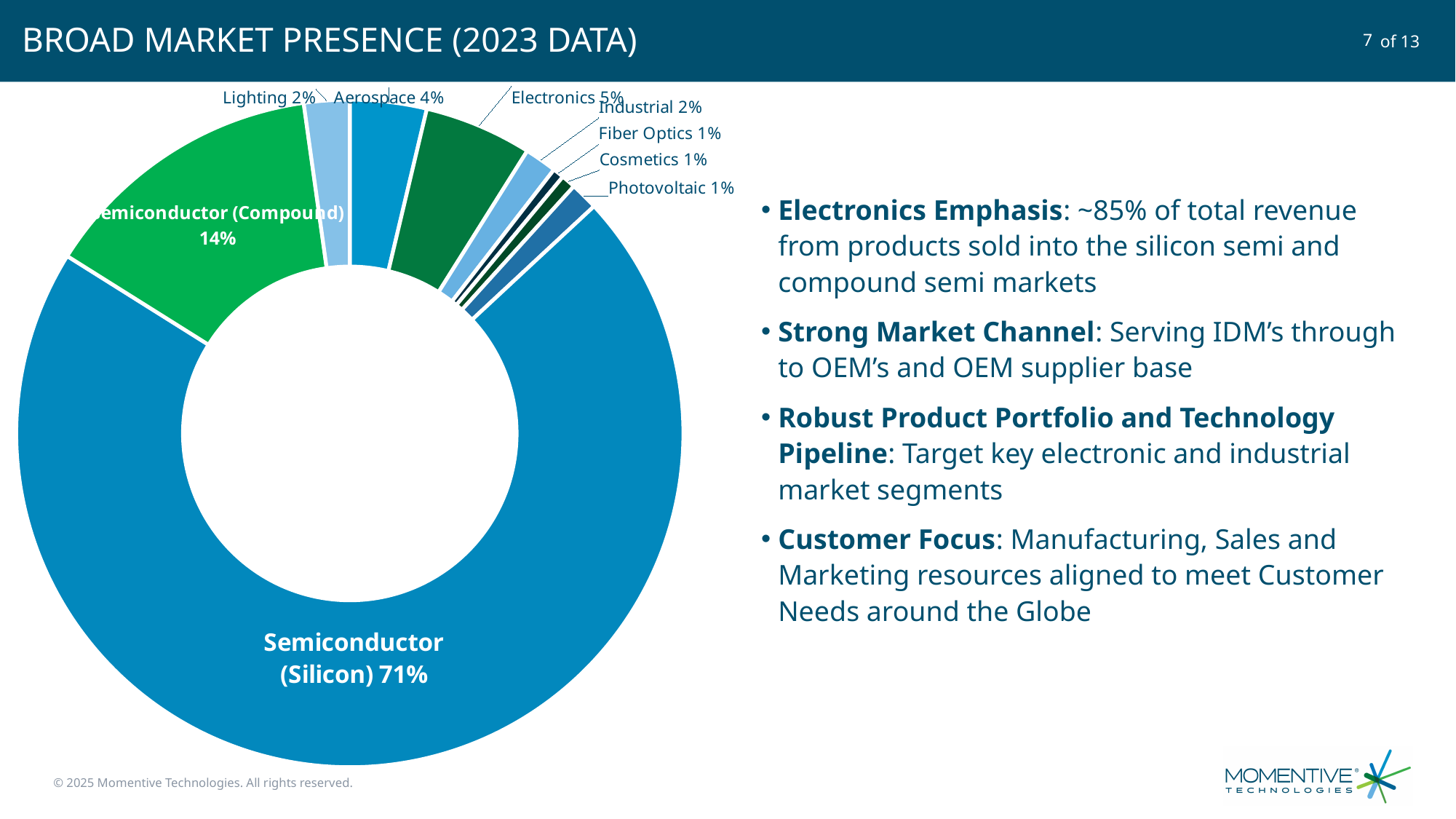
Which is larger, the Aerospace slice or the Electronics slice? Electronics What is the value shown for Aerospace? 4% What is the value shown for Semiconductor (Compound)? 14% What is the value shown for Lighting? 2% What share of the pie does Semiconductor (Silicon) hold? 71% What is the value shown for Electronics? 5% What is the title of the slide containing the chart? BROAD MARKET PRESENCE (2023 DATA) What kind of chart is shown on the slide? Pie chart (donut) How many categories are shown in the pie chart? 9 What is the difference between the Semiconductor (Silicon) share and the Semiconductor (Compound) share? 57 percentage points Which category has the largest slice of the pie? Semiconductor (Silicon) What is the combined share of Semiconductor (Silicon) and Semiconductor (Compound)? 85%